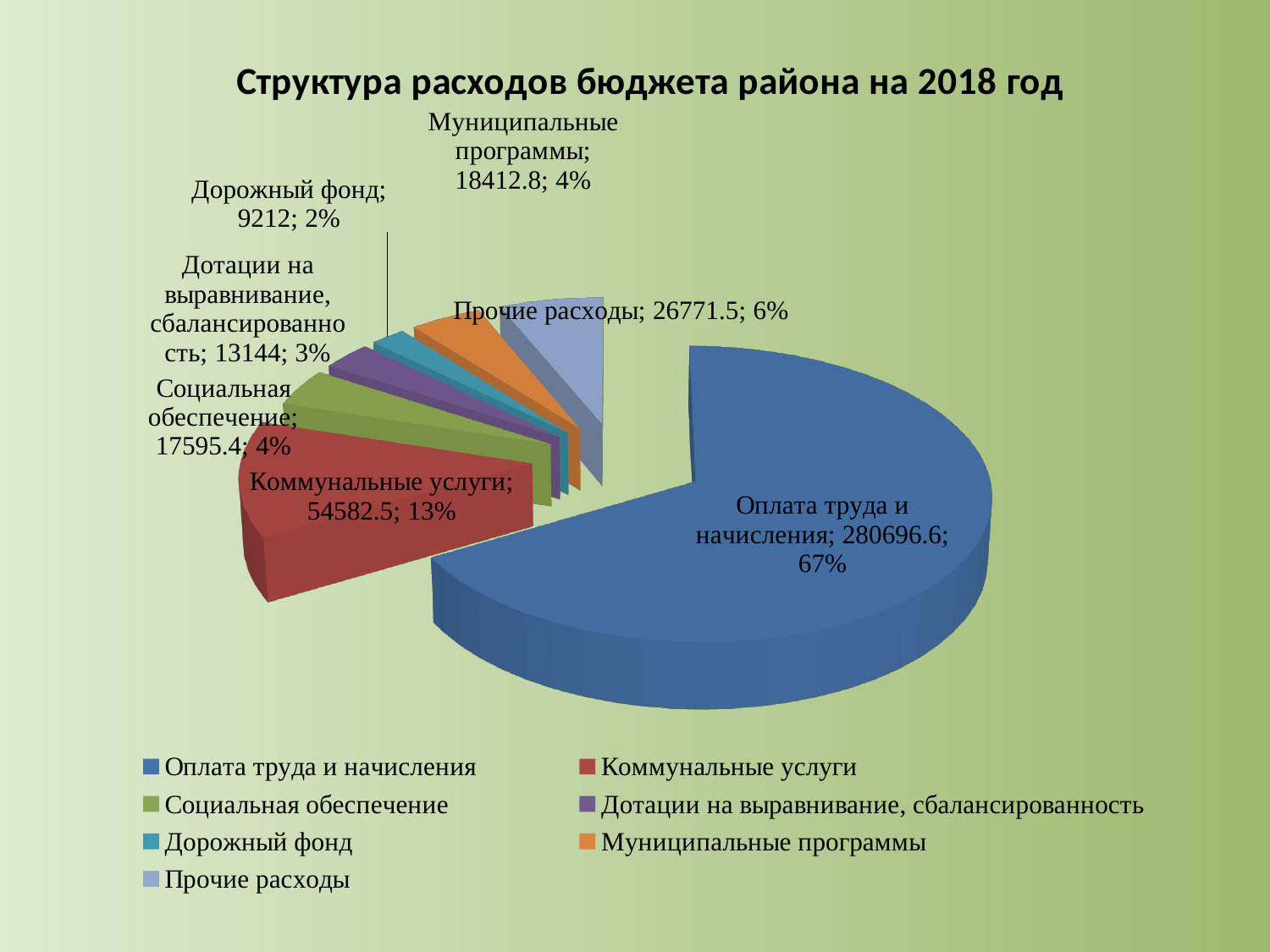
What is the value for Коммунальные услуги? 54582.5 What is the difference between the values for Коммунальные услуги and Прочие расходы? 27811 Which category has the smallest value? Дорожный фонд What is the value for Муниципальные программы? 18412.8 How many categories (slices) does the pie chart have? 7 What share of the pie does Оплата труда и начисления represent? 67% What is the value for Дорожный фонд? 9212 What is the title of the chart? Структура расходов бюджета района на 2018 год What type of chart is shown on the slide? Pie chart What is the value for Оплата труда и начисления? 280696.6 Which category has the largest value? Оплата труда и начисления What share of the pie does Прочие расходы represent? 6%